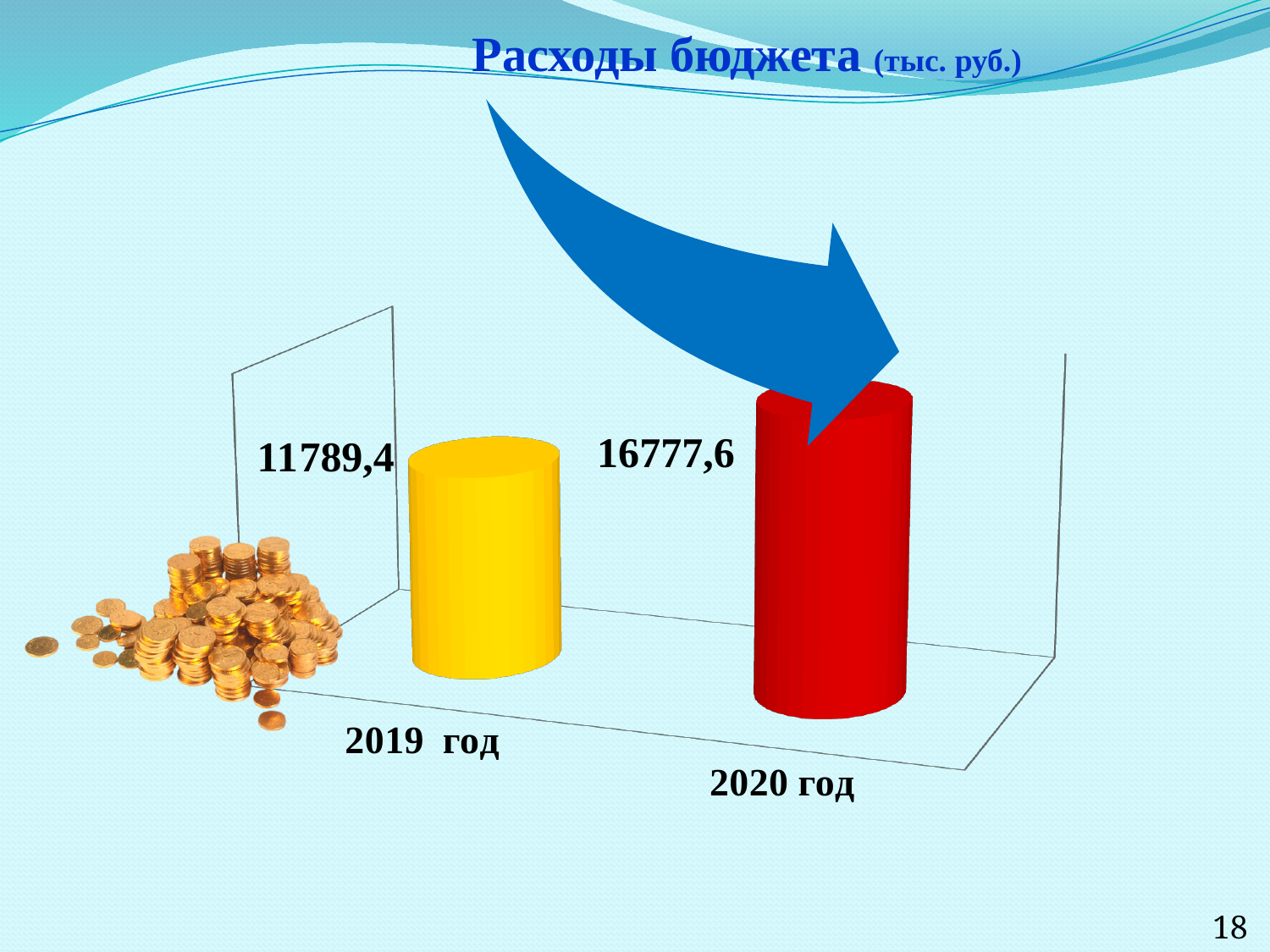
What colour is the bar for 2020 год? Red Which is larger, the value for 2019 год or the value for 2020 год? 2020 год Which year has the highest budget expenditure? 2020 год How many categories are plotted in the chart? 2 What is the value for 2019 год? 11789,4 What kind of chart is shown on the slide? Bar chart What is the title of the chart? Расходы бюджета (тыс. руб.) What is the value for 2020 год? 16777,6 Do the values rise or fall from 2019 год to 2020 год? Rise Which year has the lowest budget expenditure? 2019 год What is the difference between the values for 2020 год and 2019 год? 4988,2